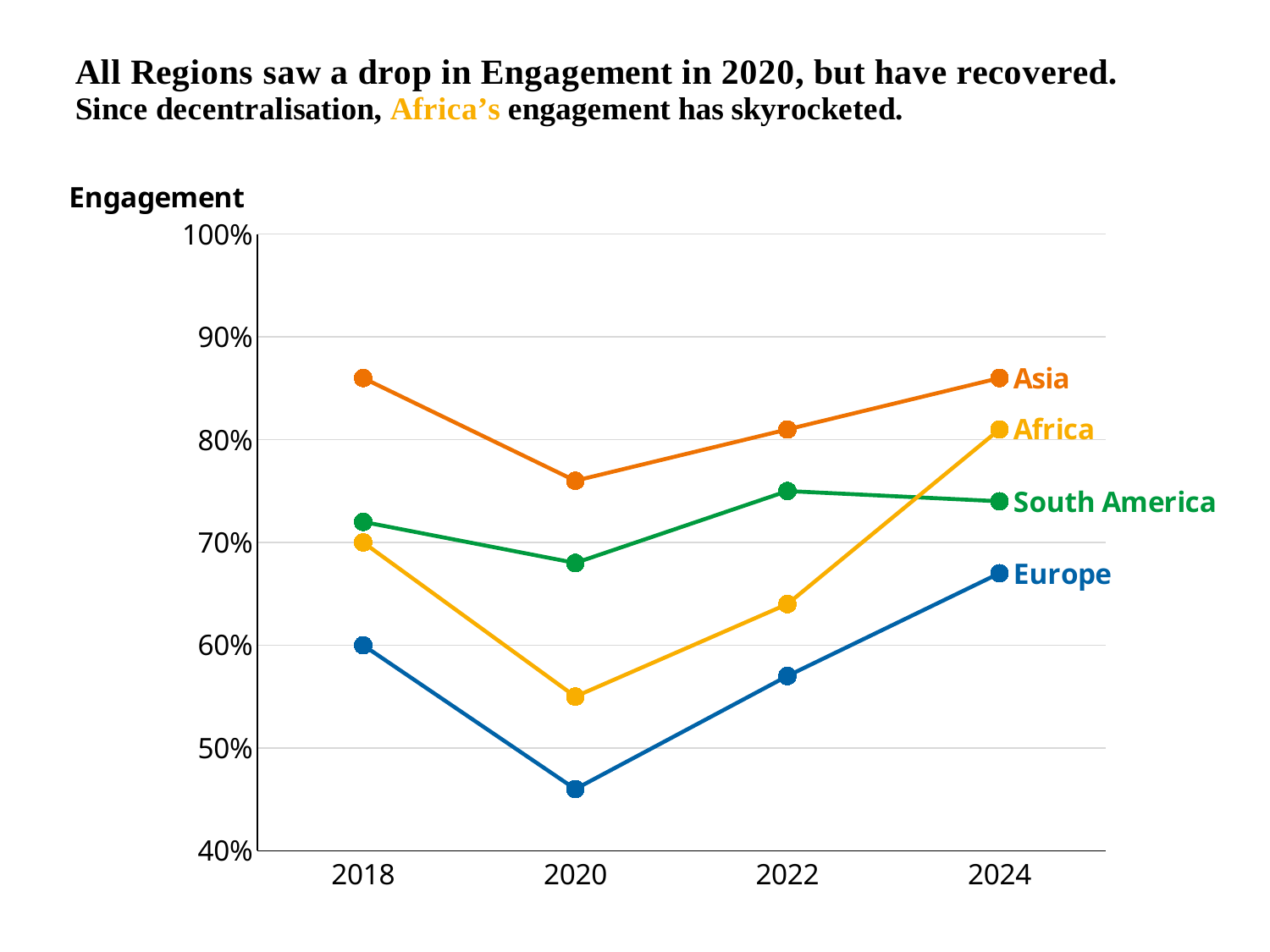
How many regions (series) are plotted on the chart? 4 Which region has the lowest engagement in 2018? Europe What is the label on the y axis of the chart? Engagement How many years are shown on the x axis? 4 Is the value for South America in 2022 greater or less than 70%? greater Is the value for Asia in 2018 greater or less than 80%? greater Is the value for Europe in 2020 greater or less than 50%? less In 2024, which has higher engagement: Africa or South America? Africa Which region has the lowest engagement in 2020? Europe Does Europe's engagement rise or fall from 2020 to 2024? rise Which region has the highest engagement in 2024? Asia What kind of chart is shown on the slide? line chart